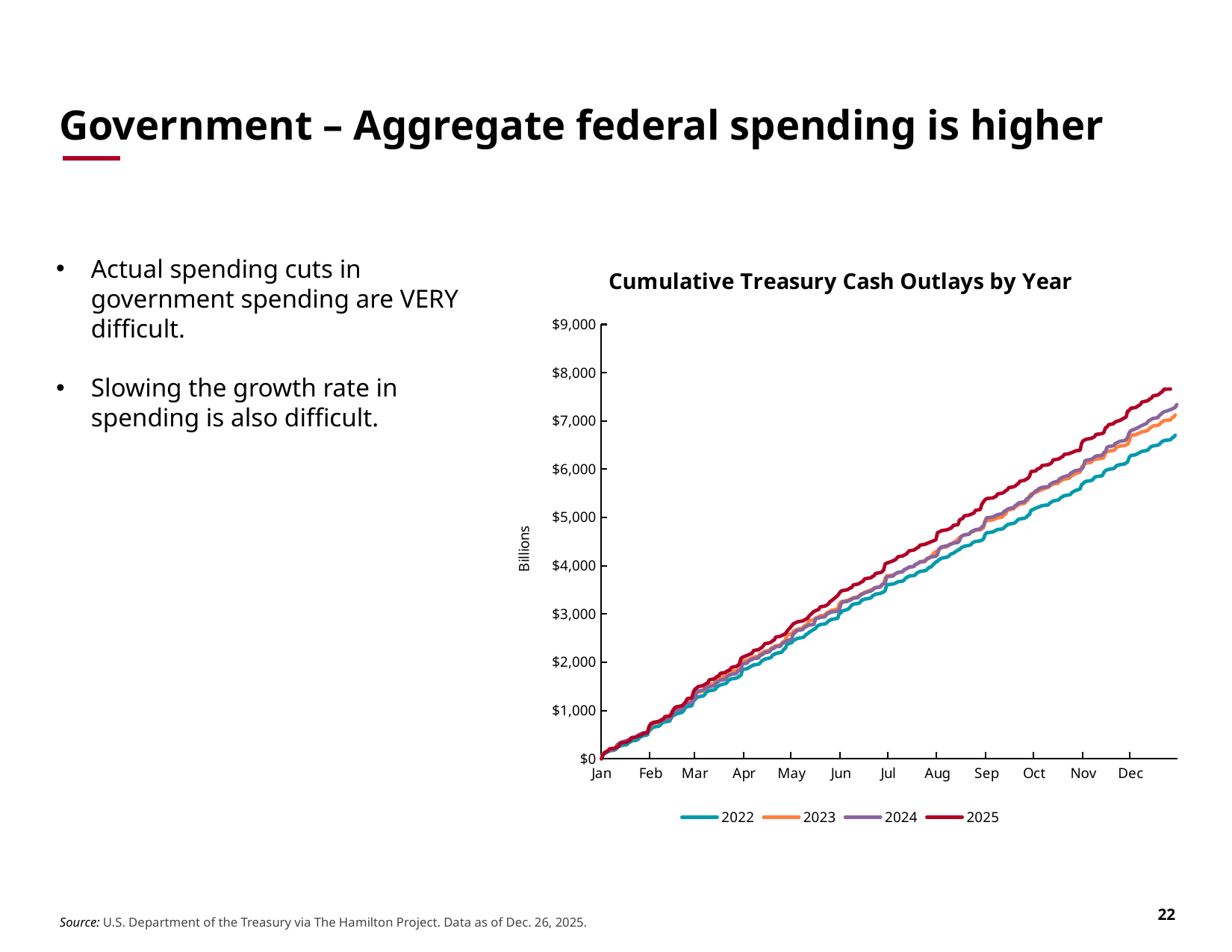
Is the value for 2025 at the end of December greater or less than $7,000? greater Which year's line ends lowest at the end of December? 2022 What kind of chart is shown on the slide? Line chart Which years are listed in the legend of the chart? 2022, 2023, 2024, 2025 Do the cumulative outlay lines rise or fall from Jan to Dec? Rise At the end of December, which is larger: the value for 2025 or the value for 2022? 2025 How many series does the legend list in the Cumulative Treasury Cash Outlays by Year chart? 4 How many month labels are shown on the x axis of the chart? 12 Which year's line ends highest at the end of December? 2025 Is the value for 2022 at the end of December greater or less than $7,000? less Is the value for 2022 at the end of December greater or less than $6,000? greater What is the title of the chart on the slide? Cumulative Treasury Cash Outlays by Year